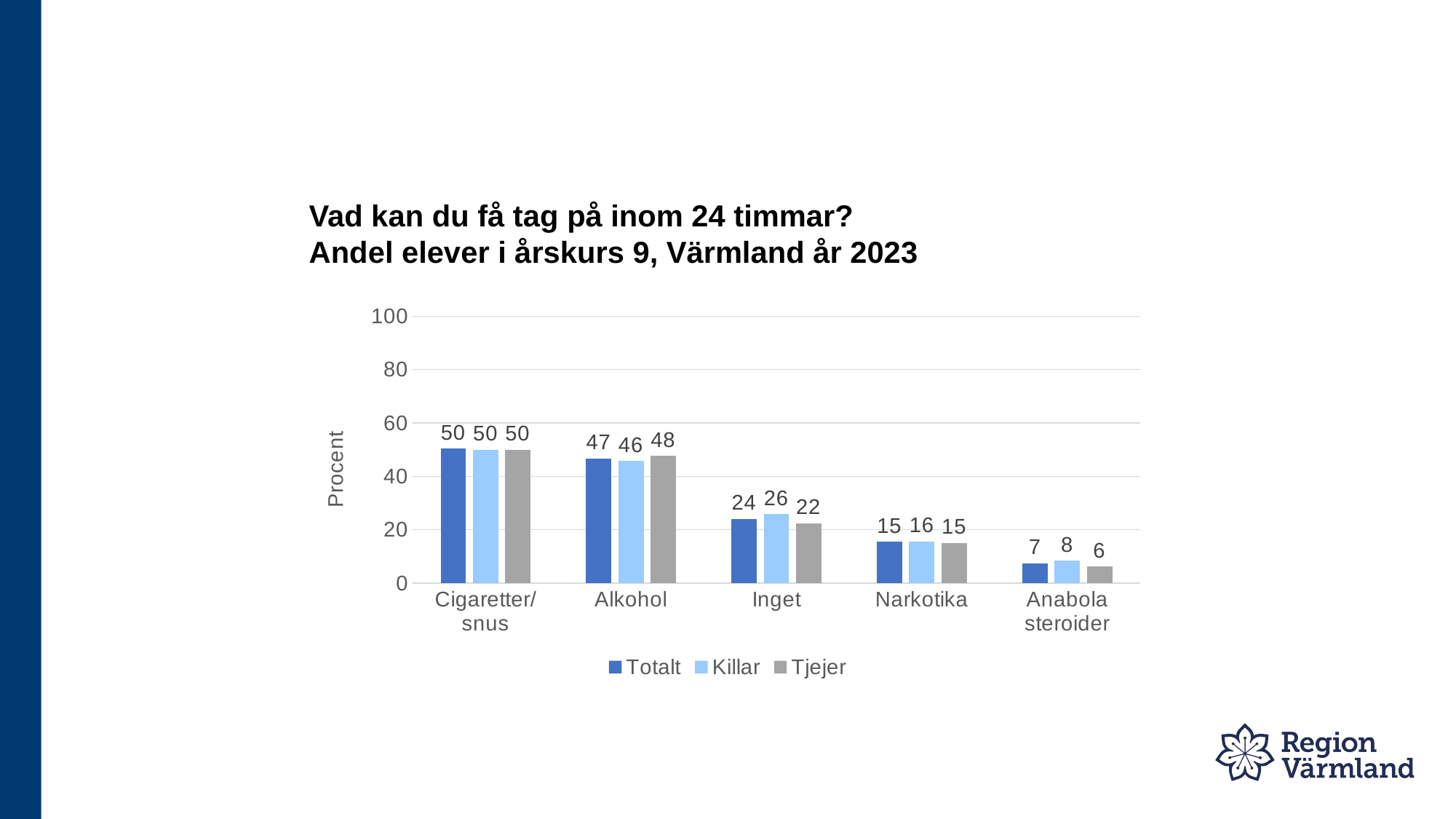
How many series does the legend list? 3 What is the Tjejer value for Anabola steroider? 6 Which is larger for Alkohol, the Killar value or the Tjejer value? Tjejer What is the label of the y axis? Procent What is the Totalt value for Alkohol? 47 What kind of chart is shown on the slide? bar chart Which category has the highest Tjejer value? Cigaretter/snus How many categories are shown on the x axis? 5 What is the difference between the Killar and Tjejer values for Inget? 4 Is the Totalt value for Narkotika greater or less than 20? less Which category has the lowest Totalt value? Anabola steroider What is the Killar value for Inget? 26